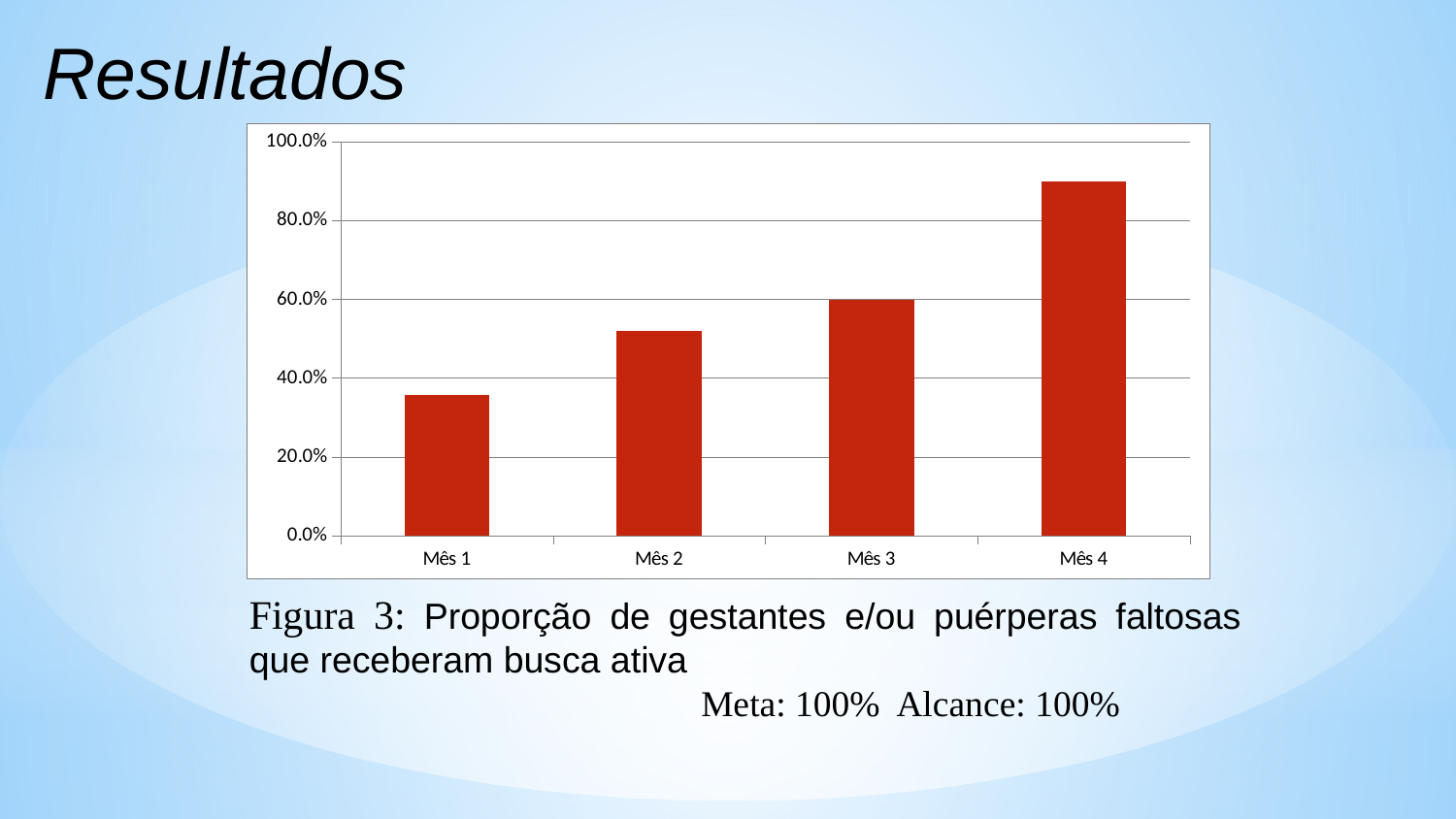
What kind of chart is shown on the slide? bar chart Which month has the highest value? Mês 4 Is the value for Mês 1 greater or less than 40.0%? less Is the value for Mês 2 greater or less than 60.0%? less Do the values rise or fall from Mês 1 to Mês 4? rise How many categories (months) are plotted on the x axis? 4 What is the figure number given in the caption below the chart? Figura 3 Is the value for Mês 4 greater or less than 80.0%? greater Which is larger, the value for Mês 2 or the value for Mês 4? Mês 4 What colour are the bars in the chart? red Which month has the lowest value? Mês 1